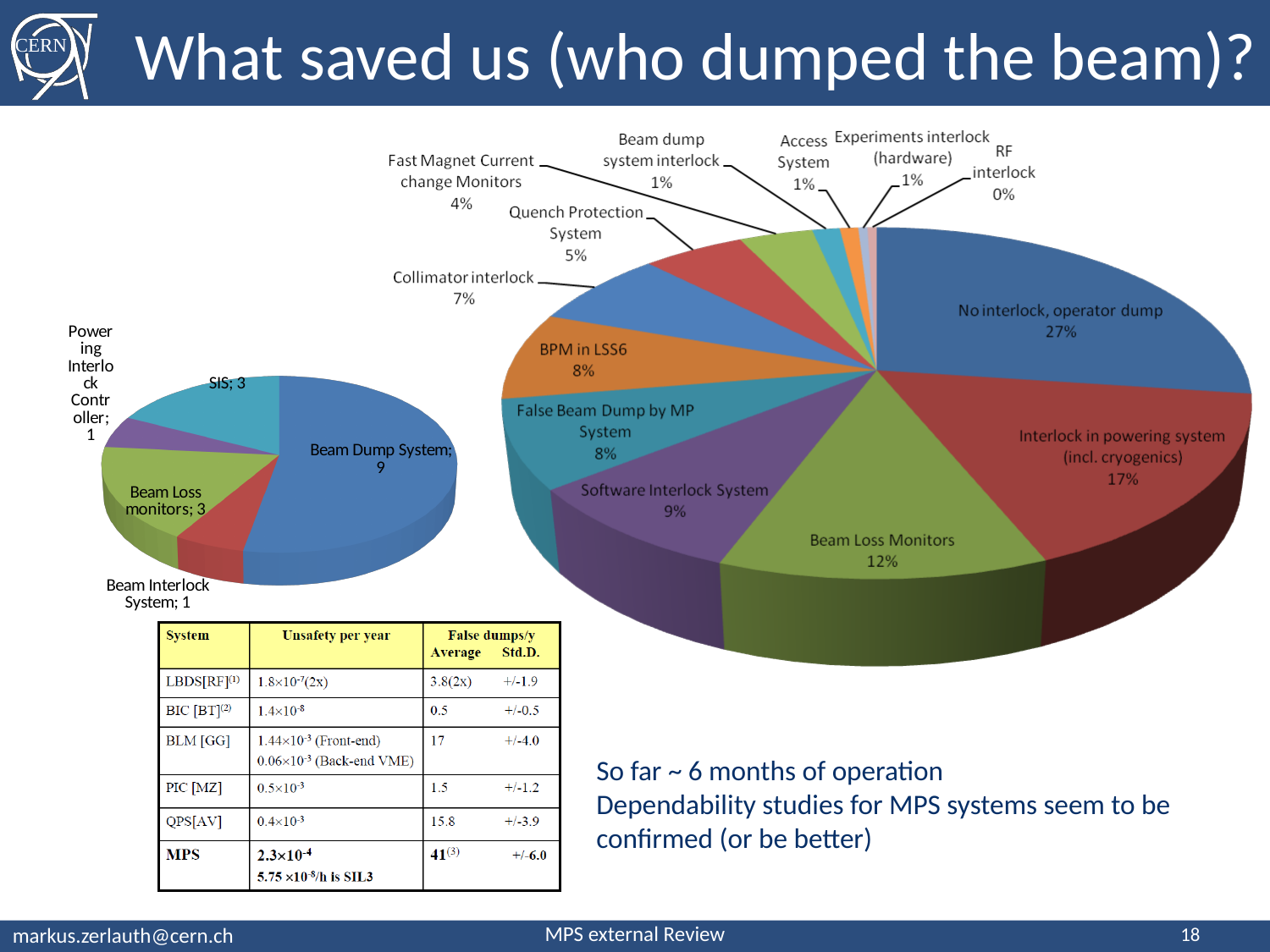
In the large pie chart on the right, what is the difference in percentage points between 'Interlock in powering system (incl. cryogenics)' and 'Software Interlock System'? 8 In the small pie chart on the left, which category has the largest value? Beam Dump System In the large pie chart on the right, which category has the largest share? No interlock, operator dump In the large pie chart on the right, which is larger: 'Quench Protection System' or 'Fast Magnet Current change Monitors'? Quench Protection System In the large pie chart on the right, what share is labelled for 'Beam Loss Monitors'? 12% In the small pie chart on the left, what value is shown for 'Beam Dump System'? 9 In the large pie chart on the right, what share is labelled for 'Collimator interlock'? 7% In the large pie chart on the right, what share is labelled for 'No interlock, operator dump'? 27% How many slices does the large pie chart on the right have? 13 In the small pie chart on the left, what is the difference between 'Beam Dump System' and 'SIS'? 6 In the large pie chart on the right, which category has the smallest share? RF interlock What kind of chart is the large chart on the right side of the slide? pie chart